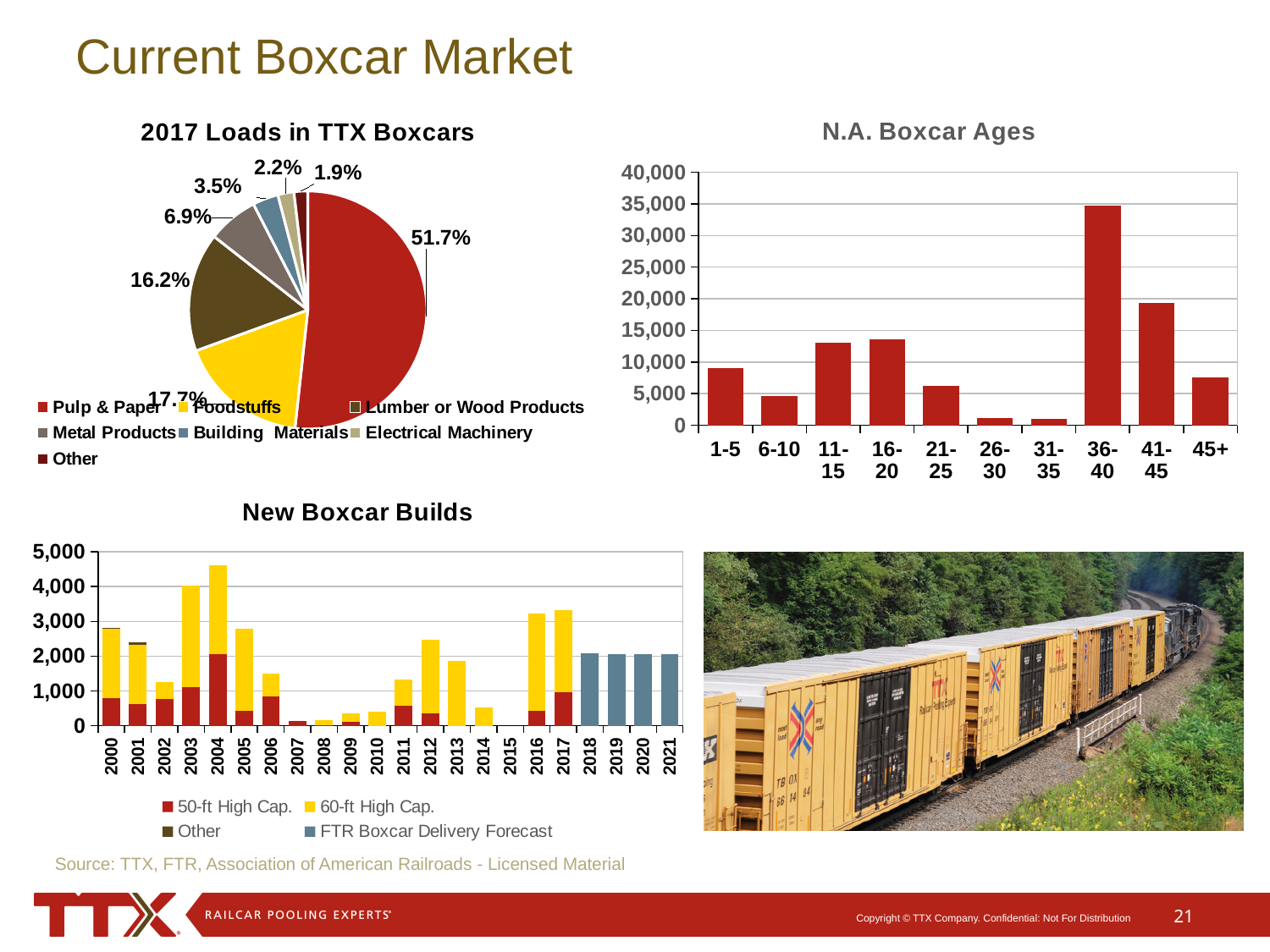
What kind of chart is the New Boxcar Builds chart? Stacked bar chart How many series does the legend of the New Boxcar Builds chart list? 4 In the N.A. Boxcar Ages chart, is the value for the 41-45 age group greater or less than 15,000? greater In the 2017 Loads in TTX Boxcars pie chart, which category has the largest share? Pulp & Paper In the N.A. Boxcar Ages chart, which age group has the highest number of boxcars? 36-40 In the 2017 Loads in TTX Boxcars pie chart, what share of loads is Lumber or Wood Products? 16.2% In the N.A. Boxcar Ages chart, is the value for the 36-40 age group greater or less than 30,000? greater In the 2017 Loads in TTX Boxcars pie chart, which category has the smallest share? Other How many categories does the legend of the 2017 Loads in TTX Boxcars pie chart list? 7 In the 2017 Loads in TTX Boxcars pie chart, what is the difference between the Foodstuffs share and the Metal Products share? 10.8% How many age groups are shown on the x axis of the N.A. Boxcar Ages chart? 10 In the 2017 Loads in TTX Boxcars pie chart, what share of loads is Pulp & Paper? 51.7%